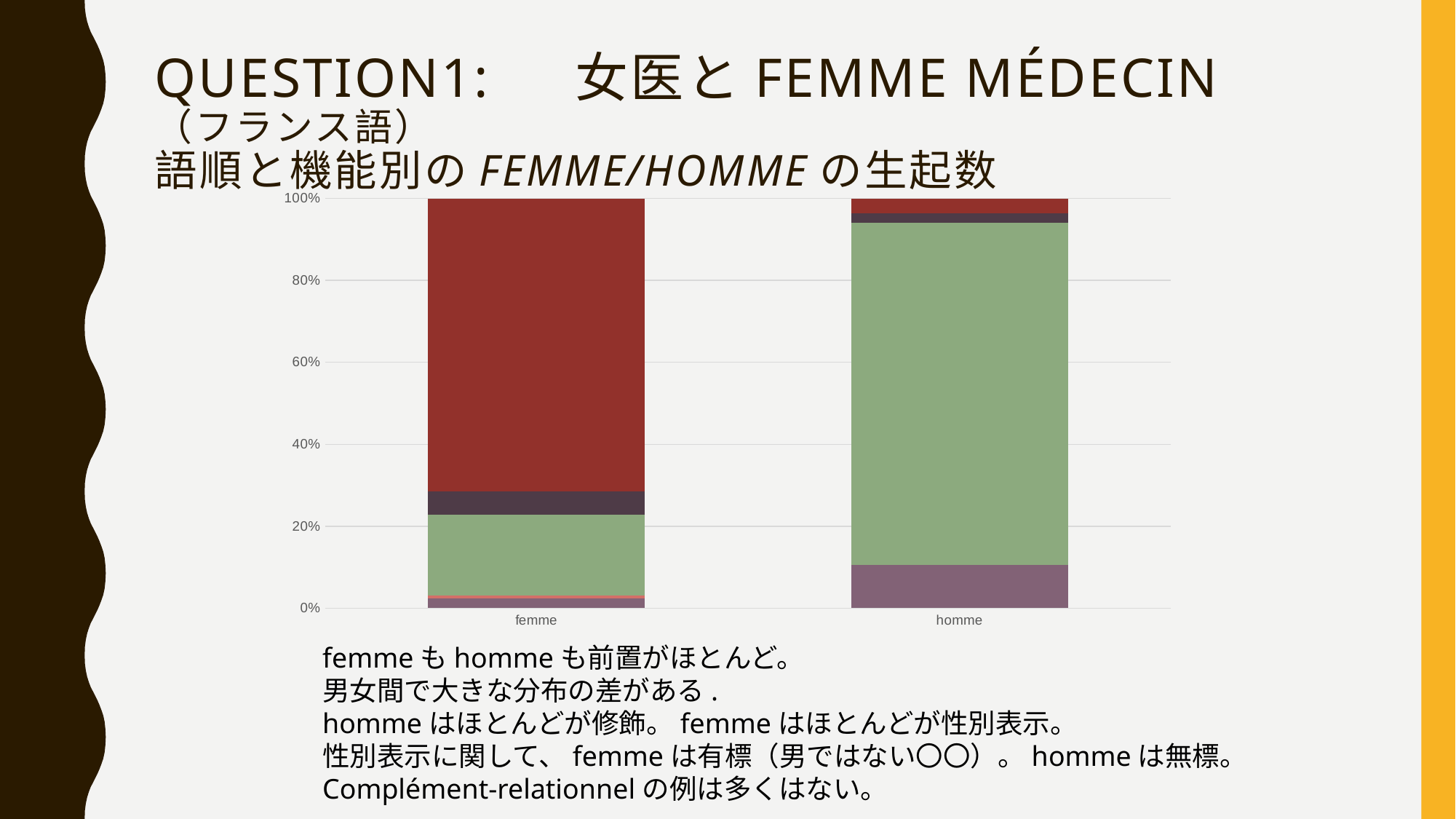
What are the two category labels on the x axis of the chart? femme and homme What kind of chart is shown on the slide? stacked bar chart In the femme bar, is the top of the dark red segment's lower boundary (where the red segment begins) greater or less than 40%? less In the femme bar, is the top of the green segment greater or less than 40%? less Which bar has the larger bottom purple segment, femme or homme? homme What is the highest value shown on the y axis of the chart? 100% In the homme bar, is the top of the green segment greater or less than 80%? greater Which bar has the larger dark red segment, femme or homme? femme Which bar has the larger green segment, femme or homme? homme How many categories are shown on the x axis of the chart? 2